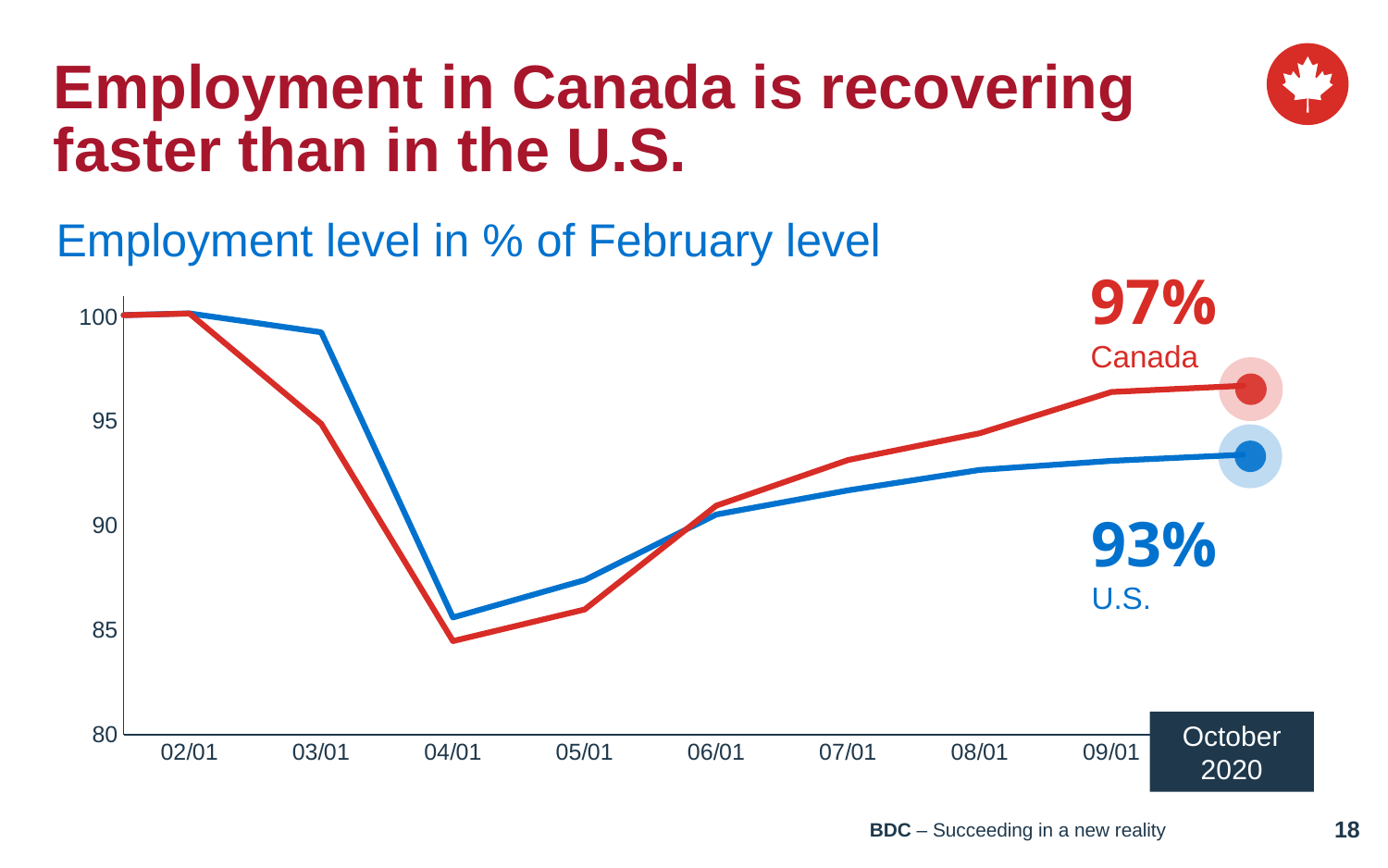
By how many percentage points does Canada's October 2020 employment level exceed that of the U.S.? 4 percentage points What kind of chart is shown on the slide? Line chart Is the value for the U.S. at 03/01 greater or less than 95? greater What colour is the line representing Canada? Red Is the value for Canada at 04/01 greater or less than 90? less What is the employment level for the U.S. in October 2020? 93% Which country has the higher employment level in October 2020, Canada or the U.S.? Canada How many series are plotted on the chart? 2 Is the value for Canada at 07/01 greater or less than 90? greater At which date do both the Canada and U.S. lines reach their lowest point? 04/01 Do the employment levels rise or fall between 04/01 and October 2020? Rise What is the employment level for Canada in October 2020? 97%